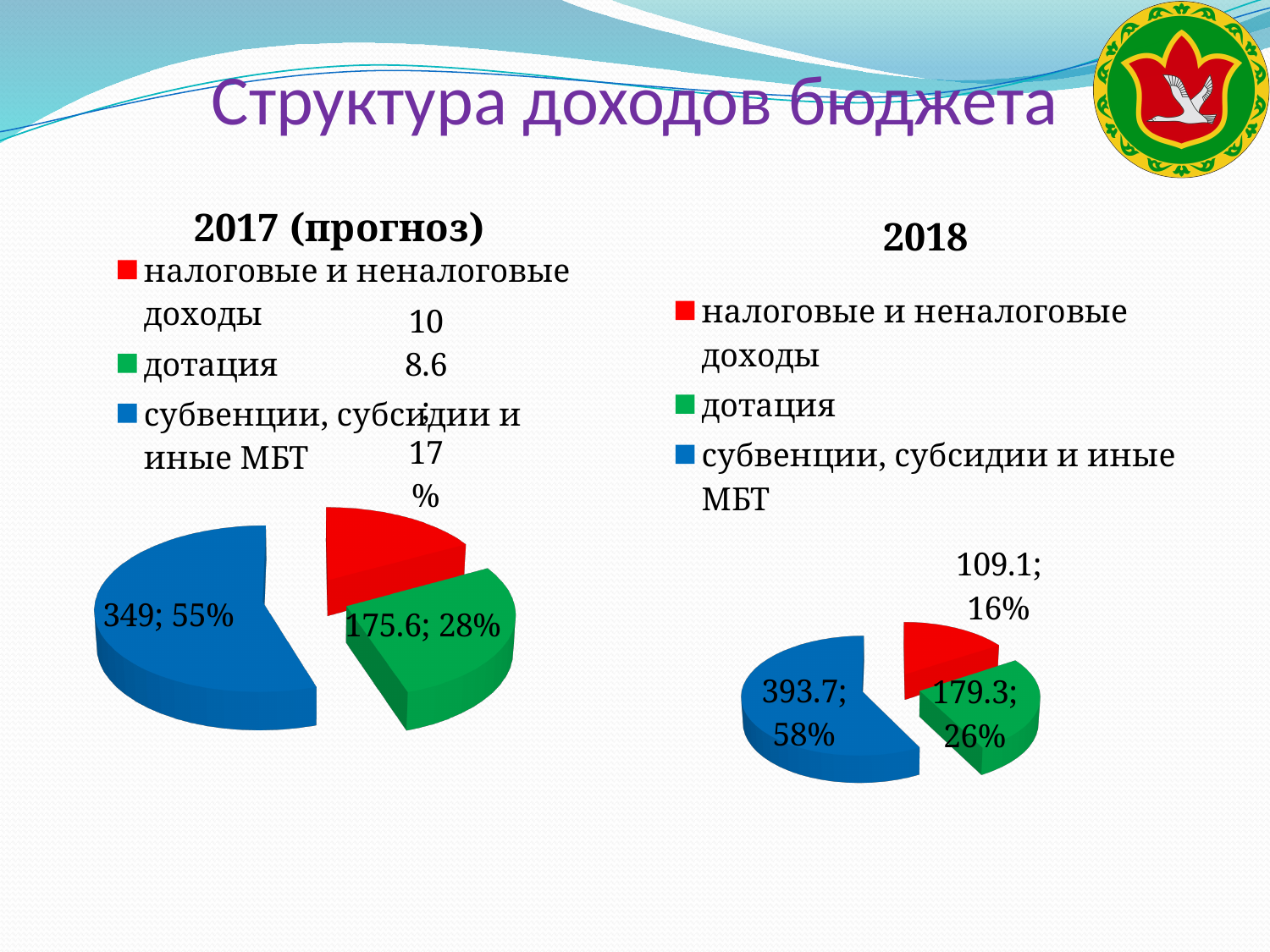
In the "2017 (прогноз)" chart, which category is the smallest? налоговые и неналоговые доходы In the "2018" chart, what is the difference between the values for субвенции, субсидии и иные МБТ and дотация? 214.4 In the "2018" chart, what share of the pie does субвенции, субсидии и иные МБТ take? 58% In the "2018" chart, what is the value for налоговые и неналоговые доходы? 109.1 In the "2018" chart, what is the value for субвенции, субсидии и иные МБТ? 393.7 In the "2018" chart, which category is the largest? субвенции, субсидии и иные МБТ What kind of chart is the "2017 (прогноз)" chart? pie chart How many categories does the legend of the "2018" chart list? 3 In the "2018" chart, what is the value for дотация? 179.3 In the "2017 (прогноз)" chart, what is the value for субвенции, субсидии и иные МБТ? 349 In the "2017 (прогноз)" chart, what share of the pie does дотация take? 28% In the "2017 (прогноз)" chart, what is the value for дотация? 175.6